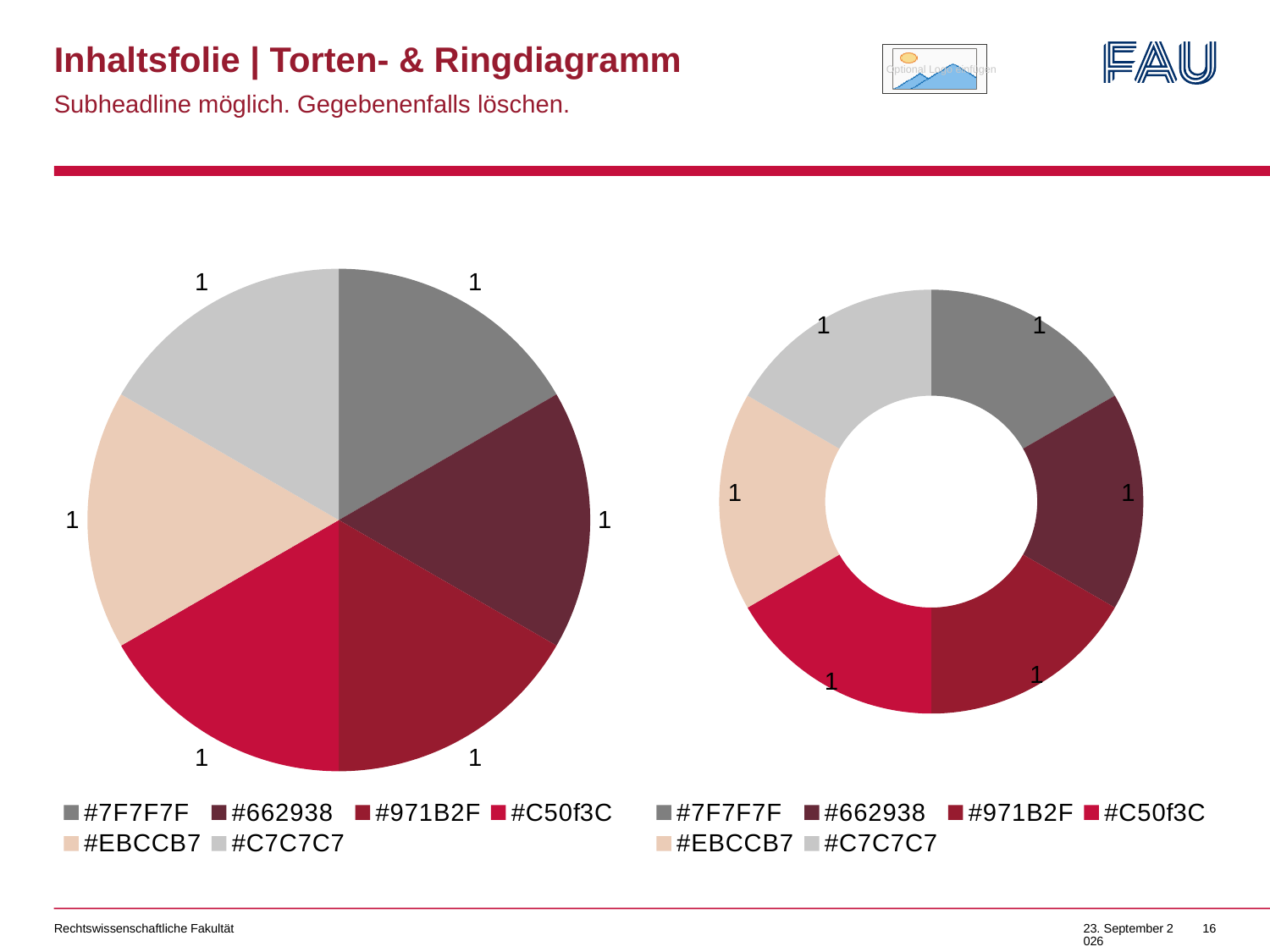
In the pie chart on the left, what is the value shown for #7F7F7F? 1 In the doughnut chart on the right, how many segments are there? 6 What kind of chart is the chart on the right side of the slide? doughnut chart How many entries does the legend of the pie chart on the left list? 6 In the pie chart on the left, how many slices are there? 6 In the pie chart on the left, what is the difference between the values for #662938 and #C7C7C7? 0 In the doughnut chart on the right, what is the total of all segment values? 6 In the doughnut chart on the right, what is the value shown for #EBCCB7? 1 In the doughnut chart on the right, which legend entry is shown in the lightest grey colour? #C7C7C7 In the pie chart on the left, what is the total of all slice values? 6 In the pie chart on the left, what is the value shown for #C50f3C? 1 What kind of chart is the chart on the left side of the slide? pie chart